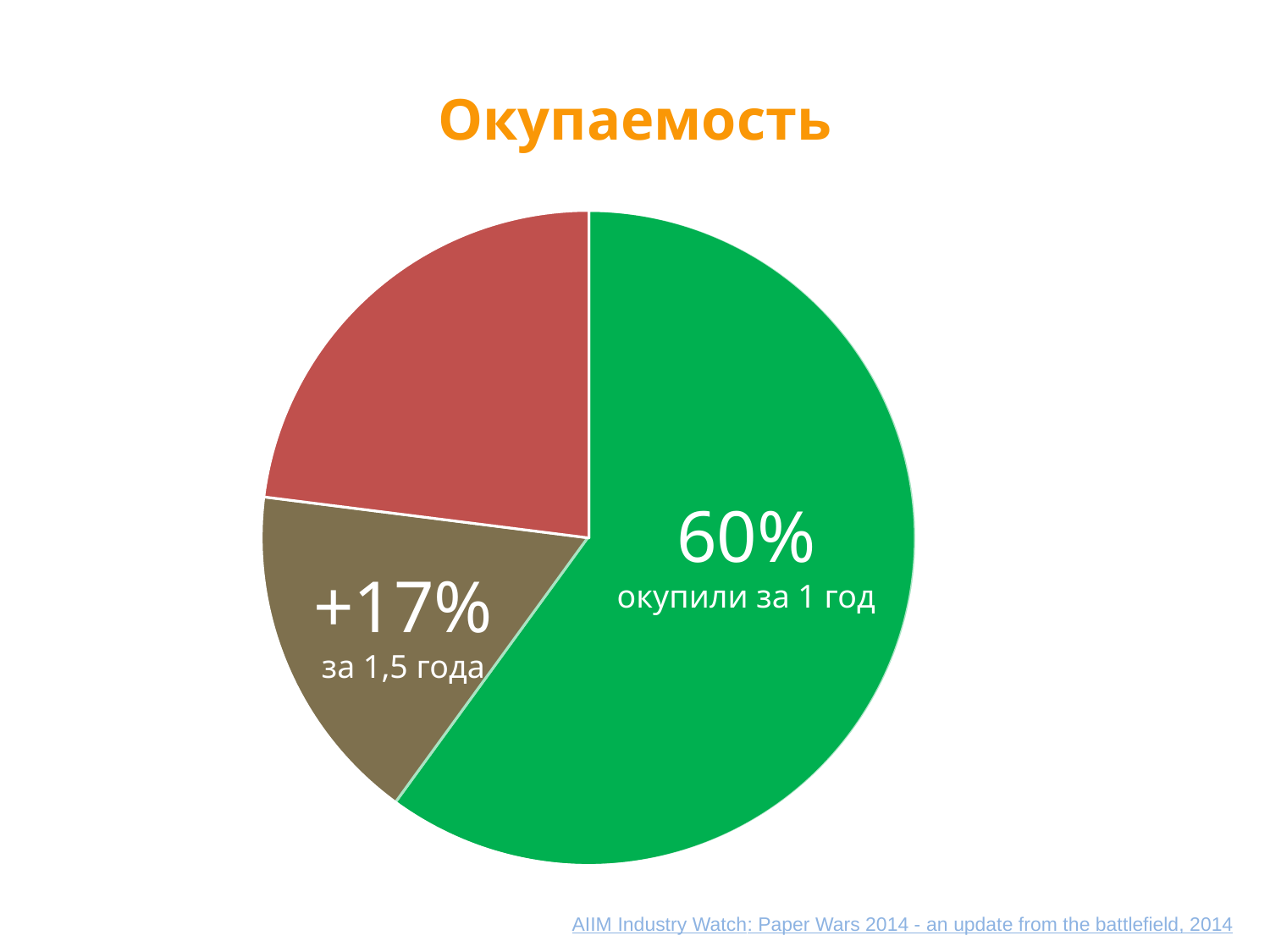
What kind of chart is shown on the slide? pie chart What label accompanies the 60% value on the pie? окупили за 1 год What time period is written under the +17% value? за 1,5 года How many slices does the pie chart have? 3 Which is larger: the slice for 'окупили за 1 год' or the slice for 'за 1,5 года'? окупили за 1 год What is the title of the chart? Окупаемость What value is printed on the brown slice of the pie? +17% Which slice of the pie is the smallest? the brown slice (+17%, за 1,5 года) What is the difference between the 60% slice and the +17% slice? 43% Which slice of the pie is the largest? the green slice (60%, окупили за 1 год) What colour is the largest slice of the pie? green What percentage is shown on the green slice of the pie? 60%